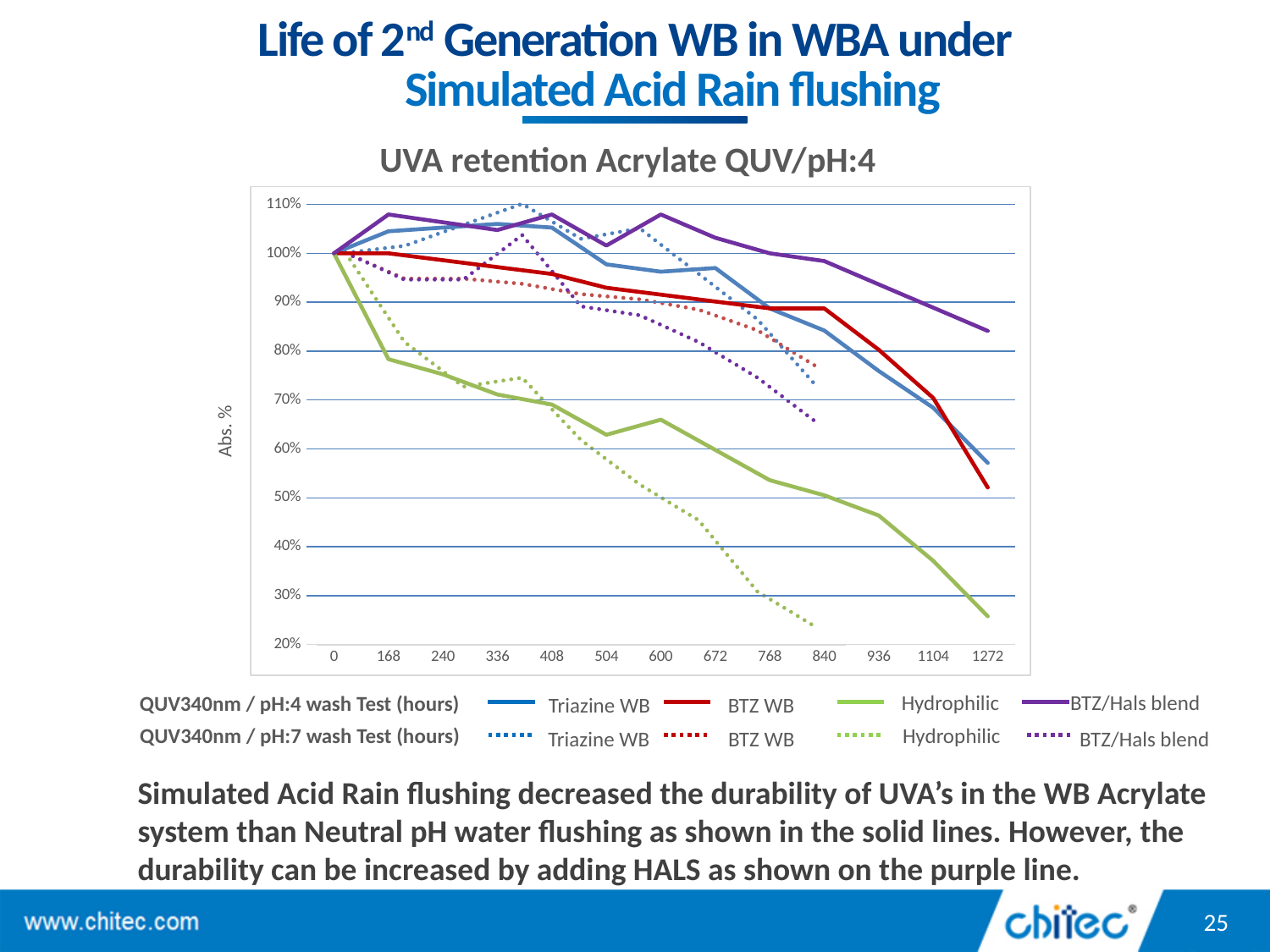
What is the value of the solid Triazine WB line at 0 hours? 100% Is the value of the solid BTZ/Hals blend line at 1272 hours greater or less than 80%? greater What is the label of the y axis? Abs. % Which solid (pH:4) series has the highest value at 1272 hours? BTZ/Hals blend What kind of chart is shown on the slide? line chart How many series does the legend list? 8 Does the solid Hydrophilic line rise or fall as the hours increase along the x axis? fall Which solid (pH:4) series has the lowest value at 1272 hours? Hydrophilic What is the title of the chart? UVA retention Acrylate QUV/pH:4 At 1272 hours, which is larger: the solid BTZ/Hals blend line or the solid Hydrophilic line? BTZ/Hals blend Is the value of the solid Hydrophilic line at 1272 hours greater or less than 30%? less How many time points are shown on the x axis? 13